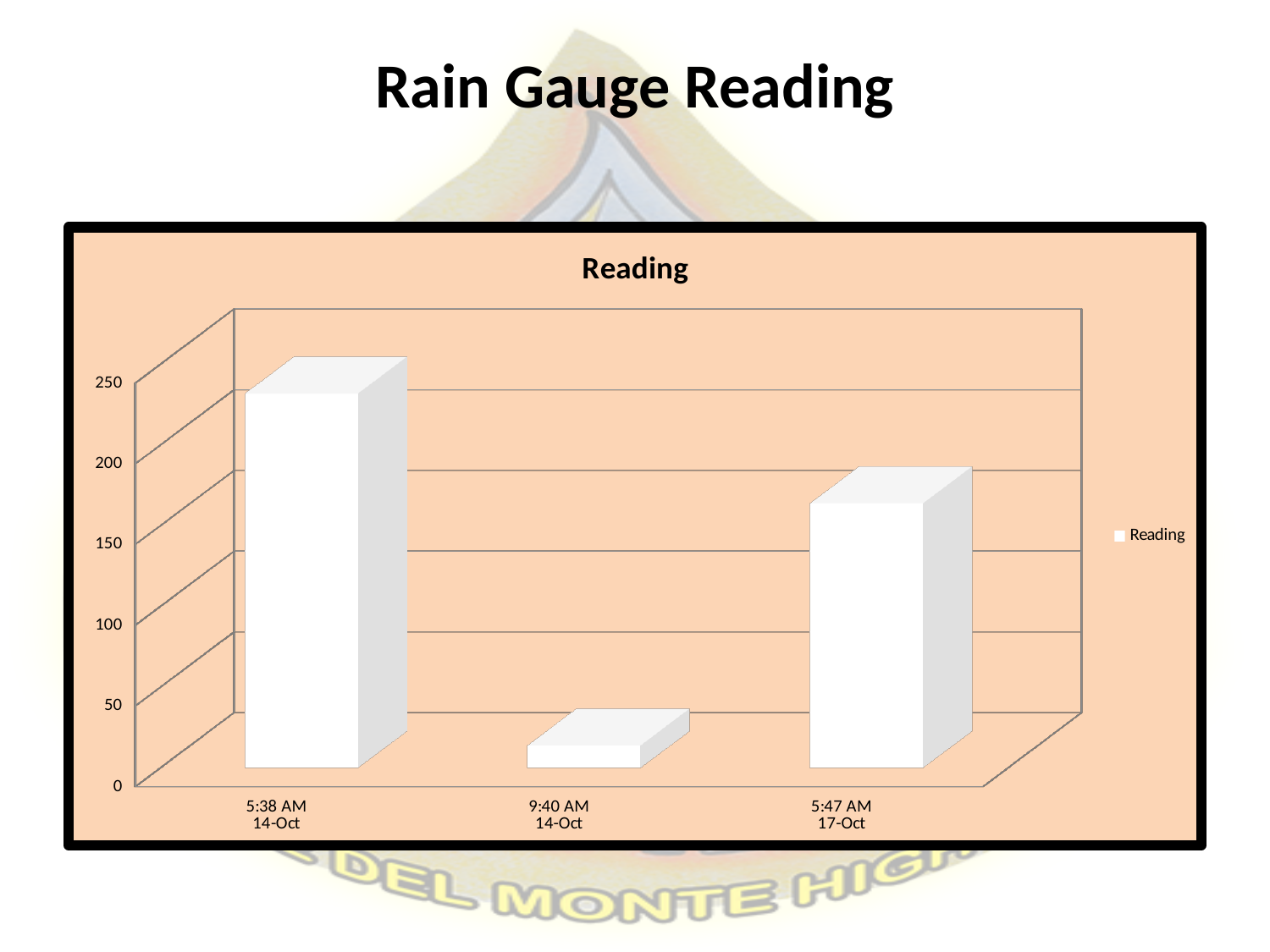
Is the reading at 5:38 AM 14-Oct greater or less than 200? greater Is the reading at 5:47 AM 17-Oct greater or less than 200? less Which category has the lowest reading? 9:40 AM 14-Oct How many series does the chart's legend list? 1 Does the reading rise or fall from 5:38 AM 14-Oct to 9:40 AM 14-Oct? fall Which category has the highest reading? 5:38 AM 14-Oct How many categories are plotted on the x axis of the chart? 3 What kind of chart is shown on the slide? bar chart Is the reading at 9:40 AM 14-Oct greater or less than 50? less Which is larger, the reading at 5:38 AM 14-Oct or the reading at 5:47 AM 17-Oct? 5:38 AM 14-Oct What is the title shown inside the chart area? Reading